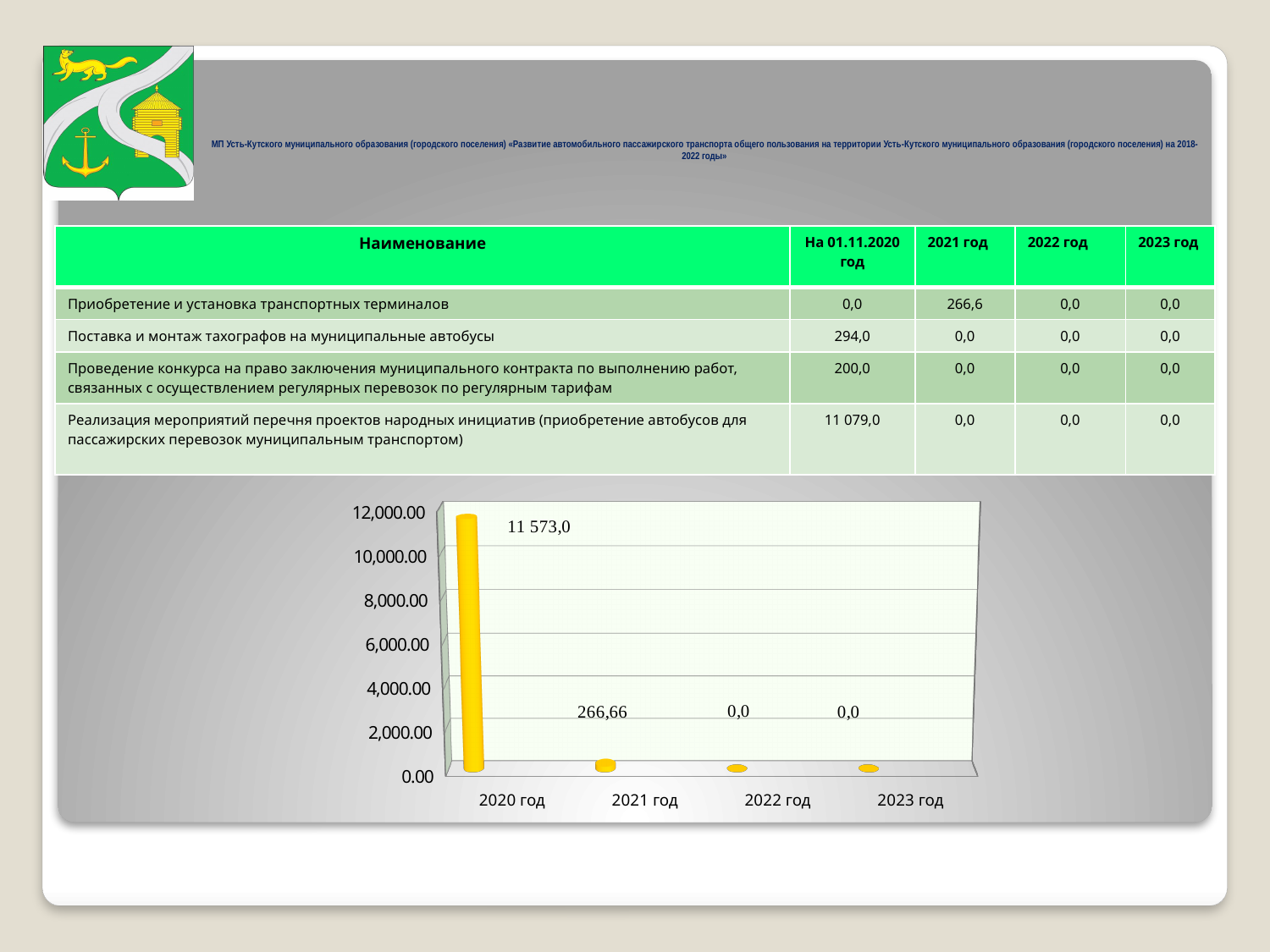
What value is shown for 2020 год in the chart? 11 573,0 Is the value for 2020 год greater or less than 10,000.00? greater What kind of chart is shown on the slide? bar chart What value is shown for 2022 год in the chart? 0,0 Which is larger in the chart, the value for 2020 год or the value for 2021 год? 2020 год Which category has the highest value in the chart? 2020 год What is the highest tick value shown on the vertical axis of the chart? 12,000.00 What value is shown for 2023 год in the chart? 0,0 Is the value for 2021 год greater or less than 2,000.00? less What value is shown for 2021 год in the chart? 266,66 Do the values in the chart rise or fall from 2020 год to 2023 год? fall How many categories are shown on the x axis of the chart? 4